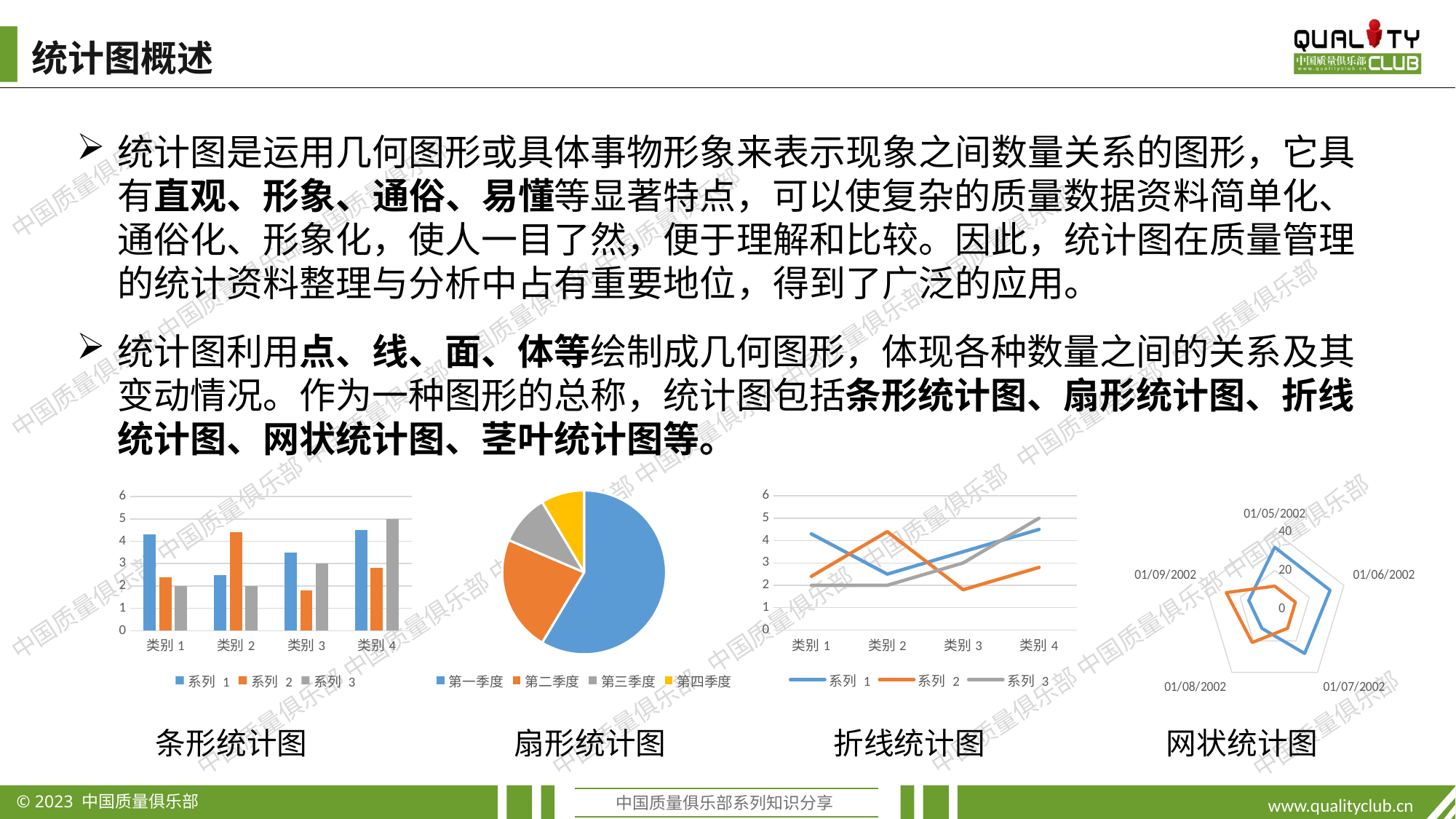
On the pie chart (扇形统计图), which slice is the largest? 第一季度 On the bar chart (条形统计图), how many categories are shown on the x axis? 4 On the line chart (折线统计图), does 系列 3 rise or fall from 类别 2 to 类别 4? rise On the radar chart (网状统计图), how many axes (categories) are there? 5 On the bar chart (条形统计图), how many series does the legend list? 3 On the bar chart (条形统计图), is the value of 系列 1 for 类别 1 greater or less than 4? greater On the bar chart (条形统计图), for 类别 3, which is larger: 系列 1 or 系列 2? 系列 1 On the bar chart (条形统计图), what is the value of 系列 3 for 类别 4? 5 On the bar chart (条形统计图), which series has the highest bar in 类别 2? 系列 2 On the line chart (折线统计图), what is the value of 系列 3 at 类别 4? 5 What kind of chart is the second chart from the left (扇形统计图)? pie chart On the pie chart (扇形统计图), how many slices are there? 4